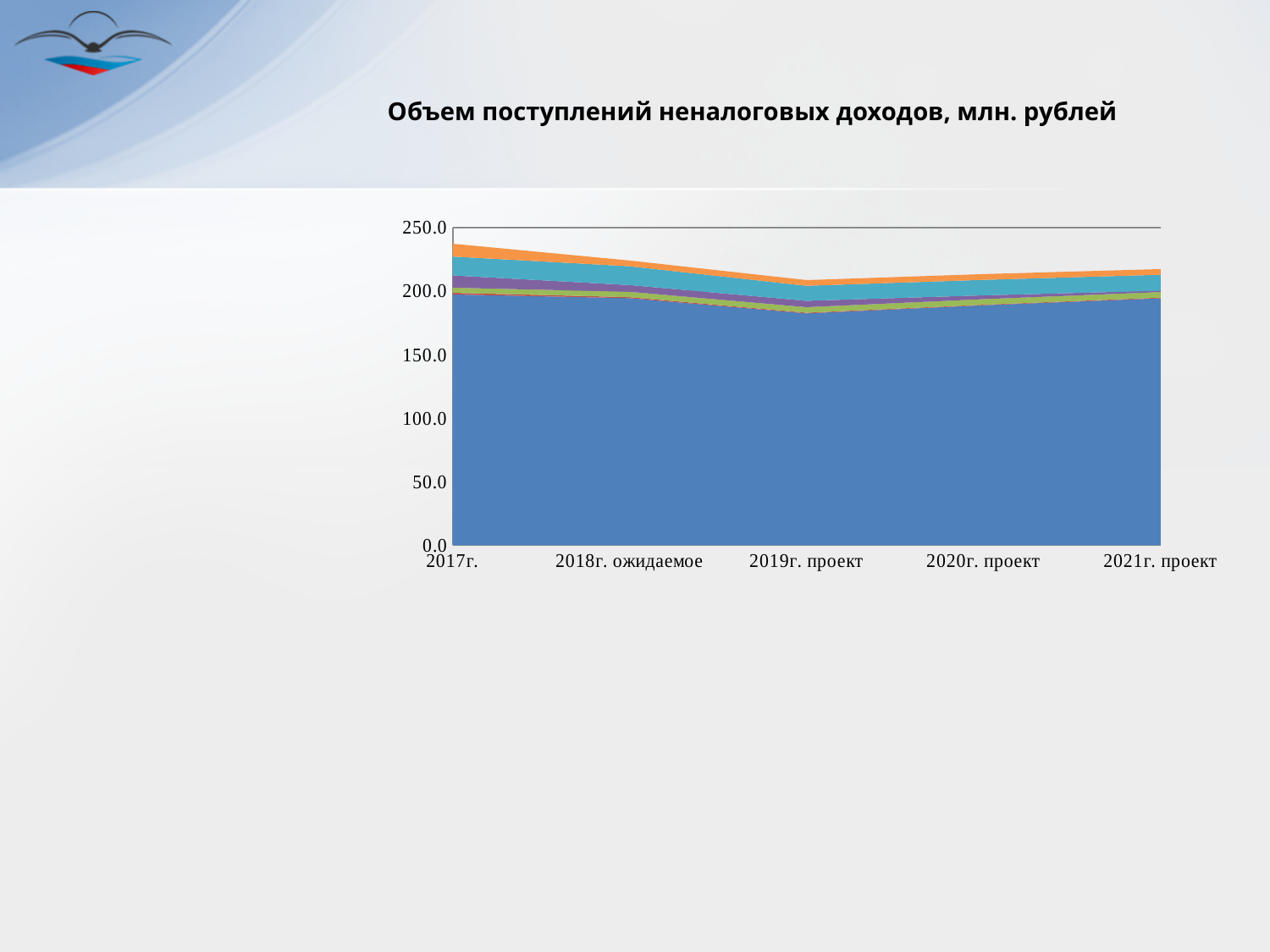
Does the total value rise or fall from 2019г. проект to 2021г. проект? rise Is the total value for 2017г. greater or less than 200? greater What kind of chart is shown on the slide? Stacked area chart How many categories are shown along the x axis? 5 Does the total value rise or fall from 2017г. to 2019г. проект? fall Which has the larger total value, 2017г. or 2019г. проект? 2017г. What is the highest value shown on the y axis? 250.0 Which category has the highest total value? 2017г. Is the total value for 2019г. проект greater or less than 250? less Is the value of the bottom (blue) series for 2019г. проект greater or less than 200? less What is the title of the chart? Объем поступлений неналоговых доходов, млн. рублей